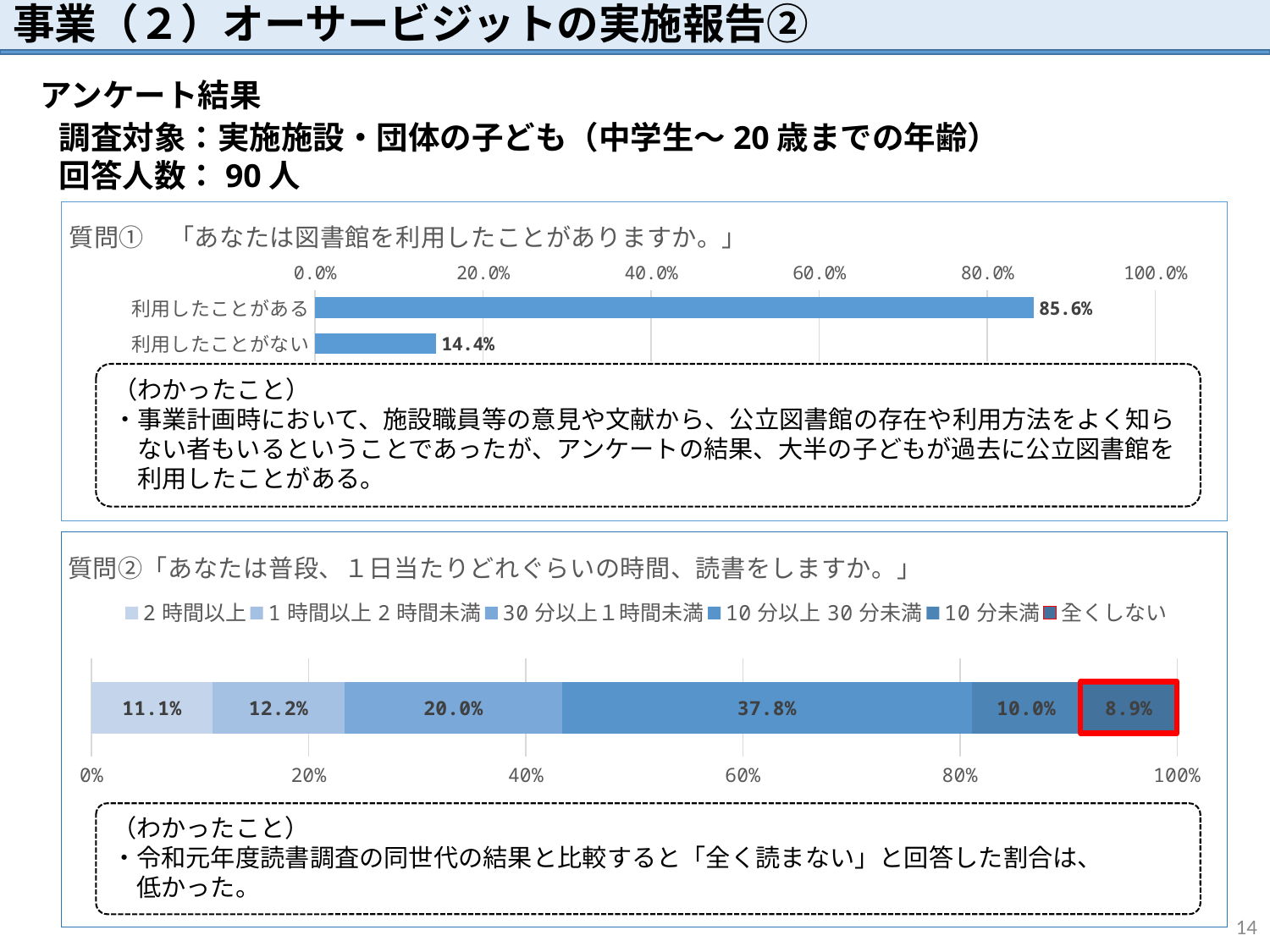
In the 質問① chart, what is the value for 利用したことがない? 14.4% In the 質問② chart, what is the value for 10分以上30分未満? 37.8% In the 質問① chart, what is the value for 利用したことがある? 85.6% In the 質問① chart, what is the difference between 利用したことがある and 利用したことがない? 71.2% In the 質問② chart, which is larger, 30分以上1時間未満 or 1時間以上2時間未満? 30分以上1時間未満 In the 質問② chart, which segment is highlighted with a red box? 全くしない In the 質問② chart, how many series does the legend list? 6 In the 質問② chart, which segment has the largest value? 10分以上30分未満 In the 質問② chart, what is the value for 全くしない? 8.9% In the 質問② chart, which segment has the smallest value? 全くしない In the 質問① chart, what kind of chart is shown? Bar chart In the 質問① chart, how many categories are plotted? 2